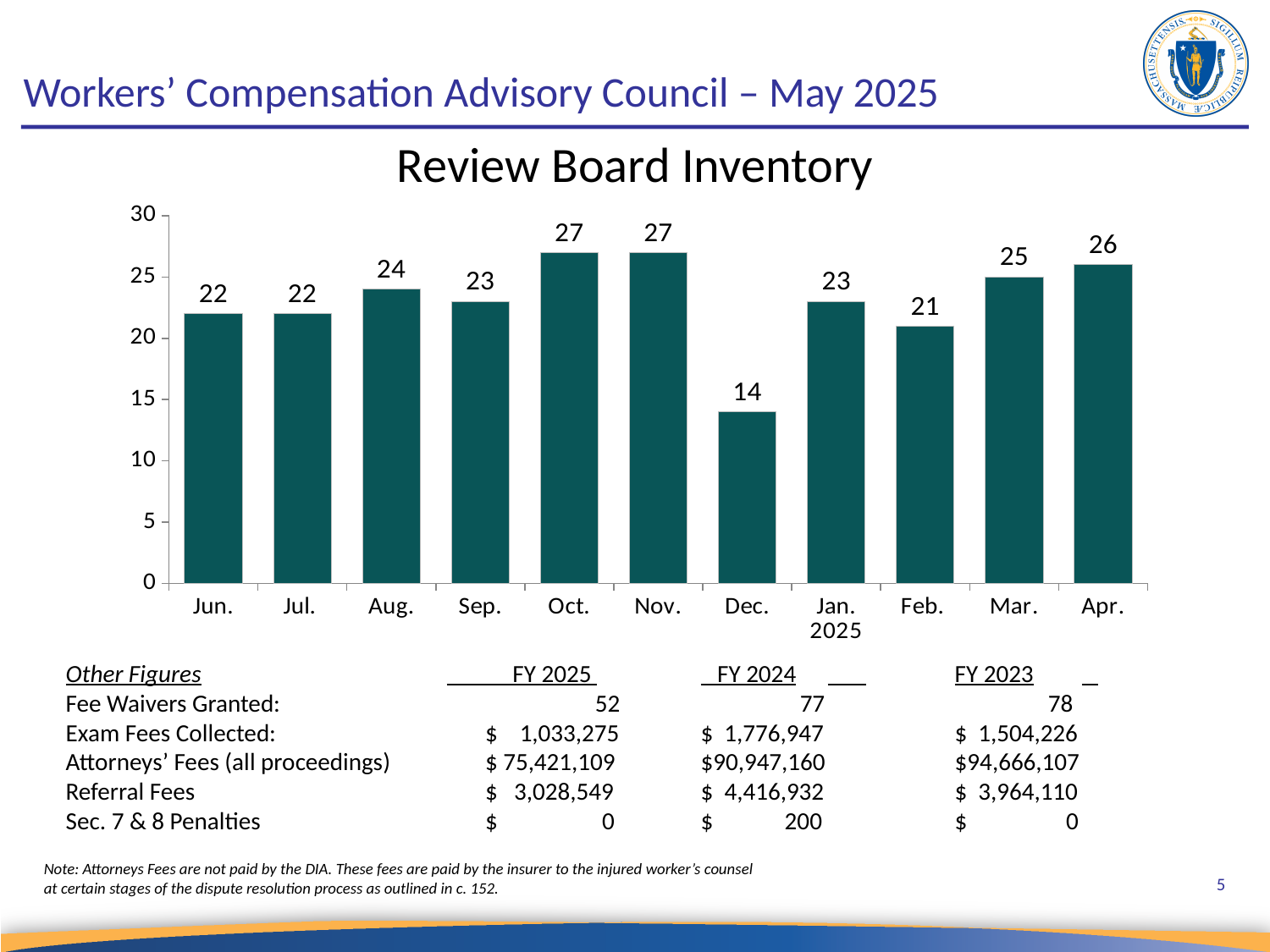
What is the difference between the Review Board Inventory in Nov. and Dec.? 13 Which month has the lowest Review Board Inventory? Dec. What is the Review Board Inventory value for Dec.? 14 What is the Review Board Inventory value for Feb.? 21 Does the Review Board Inventory rise or fall from Dec. to Apr.? rise How many months are shown on the Review Board Inventory chart? 11 Is the Review Board Inventory value for Dec. greater or less than 15? less What is the Review Board Inventory value for Apr.? 26 Which is larger, the Review Board Inventory for Aug. or for Sep.? Aug. What is the difference between the Review Board Inventory in Apr. and Jun.? 4 Which months share the highest Review Board Inventory value? Oct. and Nov. What kind of chart is the Review Board Inventory chart? bar chart